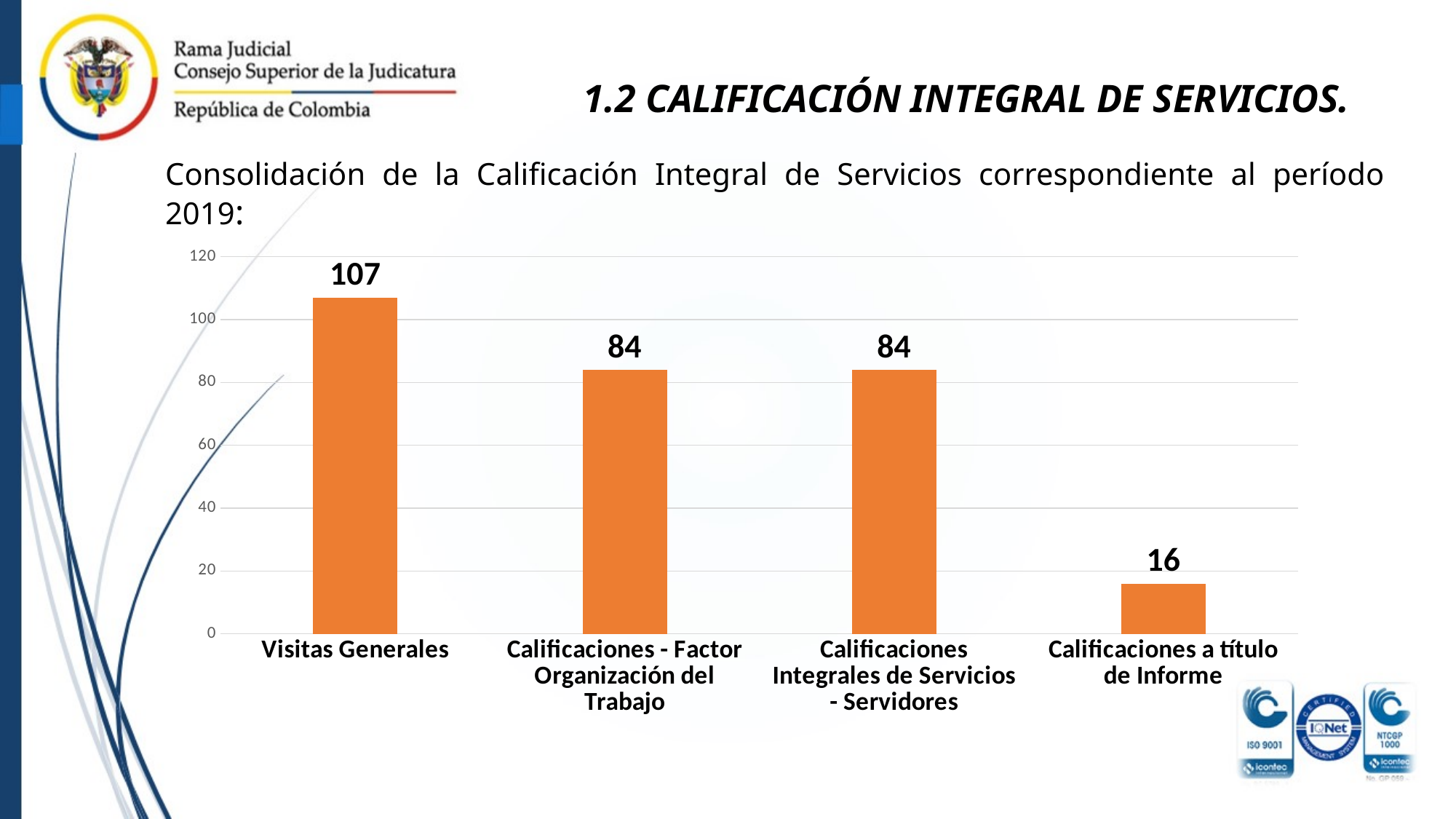
What is the value for Calificaciones a título de Informe? 16 Is the value for Visitas Generales greater or less than 100? greater What kind of chart is shown on the slide? bar chart What colour are the bars in the chart? orange What is the value for Calificaciones - Factor Organización del Trabajo? 84 What is the value for Visitas Generales? 107 Which category has the lowest value? Calificaciones a título de Informe What is the difference between the values for Visitas Generales and Calificaciones Integrales de Servicios - Servidores? 23 Which is larger, the value for Visitas Generales or the value for Calificaciones a título de Informe? Visitas Generales What is the difference between the values for Calificaciones - Factor Organización del Trabajo and Calificaciones a título de Informe? 68 Which category has the highest value? Visitas Generales How many categories are shown in the chart? 4